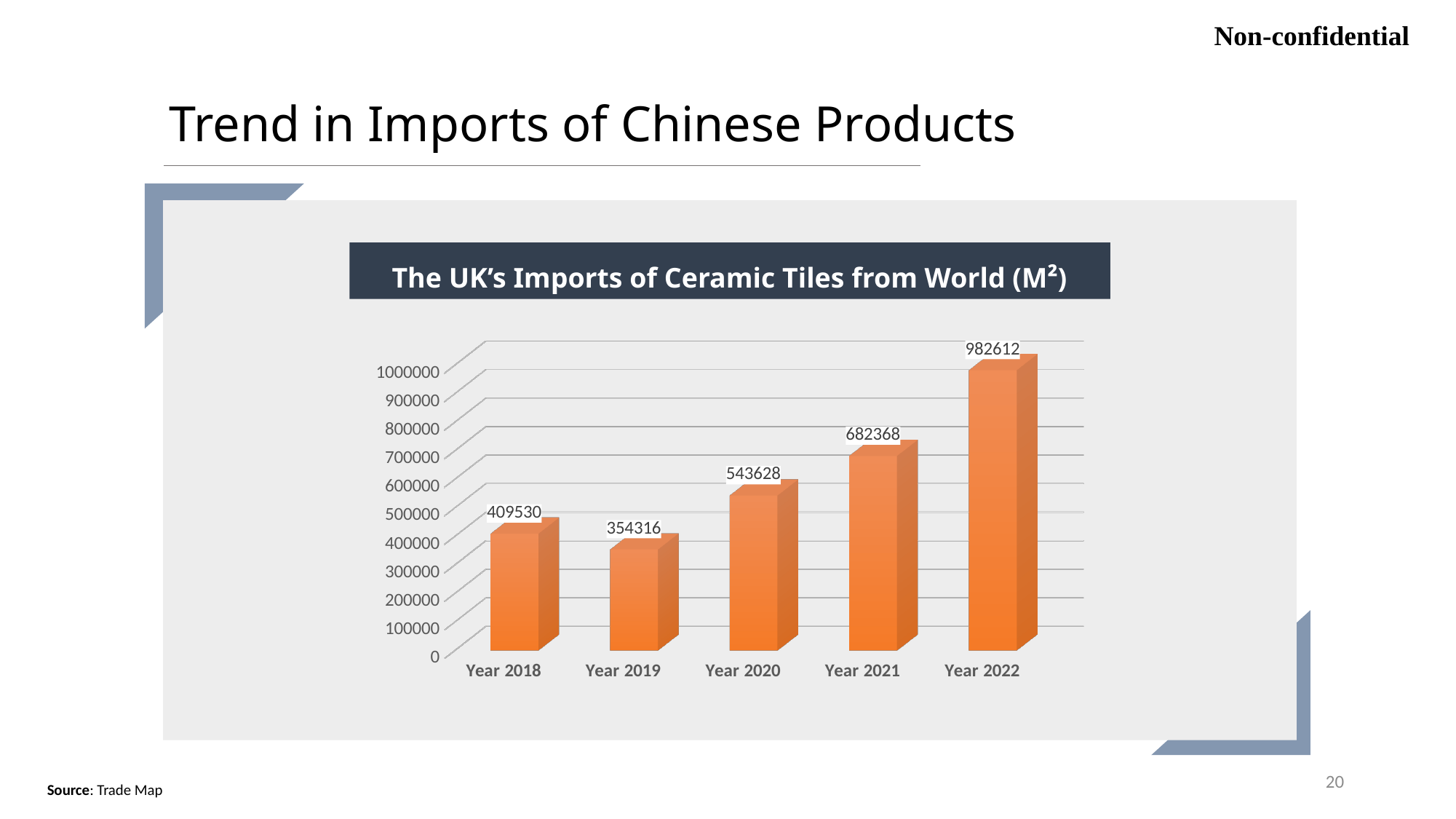
Is the value for Year 2021 greater or less than 600000? greater What kind of chart is shown on the slide? Bar chart Which year has the lowest value? Year 2019 What is the value for Year 2022? 982612 What is the value for Year 2018? 409530 What is the difference between the values for Year 2018 and Year 2019? 55214 How many years are shown on the chart? 5 Which year has the highest value? Year 2022 What is the title of the chart? The UK's Imports of Ceramic Tiles from World (M²) Which is larger, the value for Year 2020 or the value for Year 2021? Year 2021 What is the value for Year 2020? 543628 What is the difference between the values for Year 2022 and Year 2021? 300244